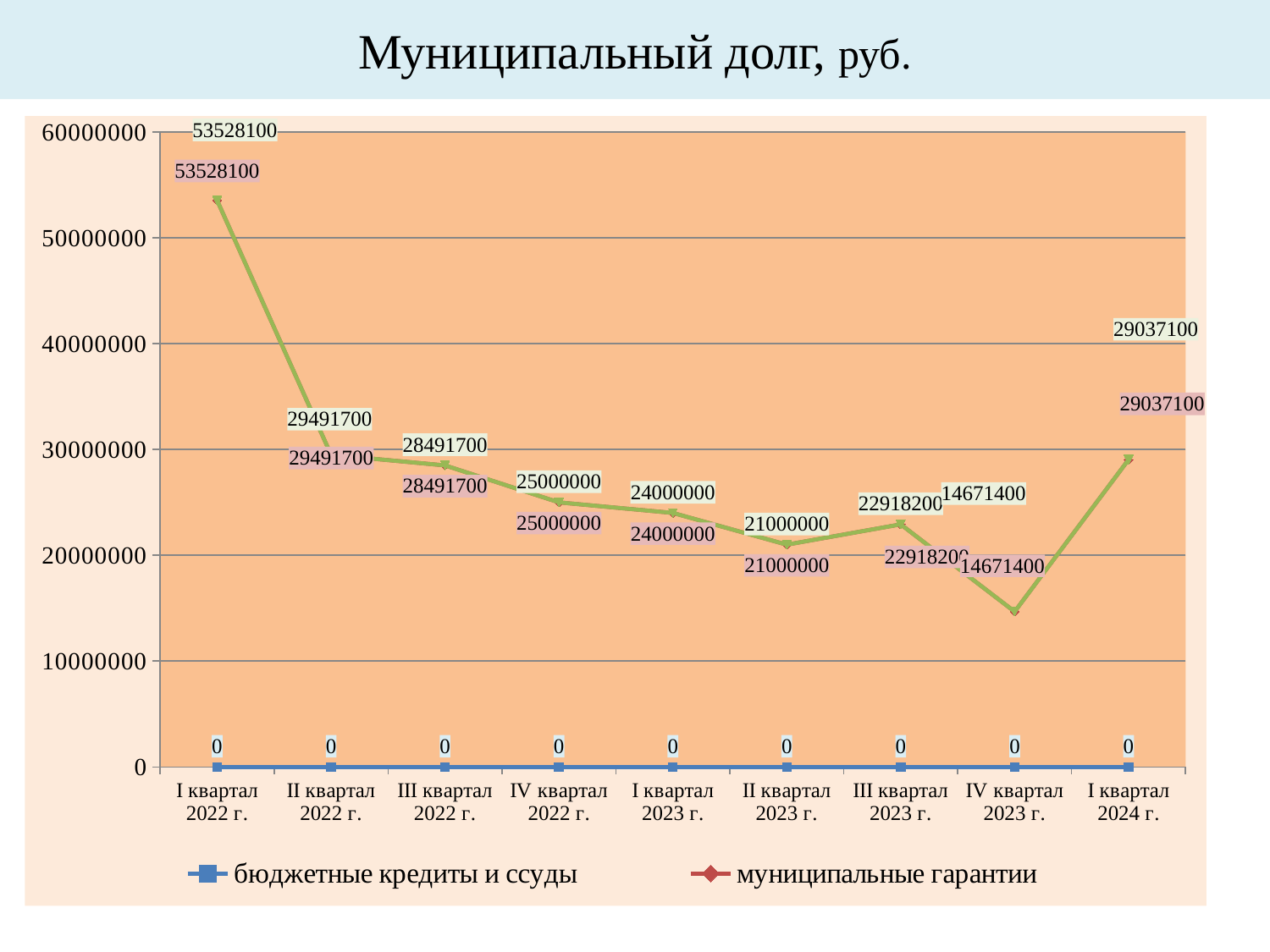
How many quarters are shown along the x axis? 9 What kind of chart is shown on the slide? line chart What value is labelled for бюджетные кредиты и ссуды in every quarter? 0 In which quarter does the upper line reach its lowest value? IV квартал 2023 г. What is the value labelled on the upper line for I квартал 2022 г.? 53528100 Which is larger on the upper line: the value for III квартал 2023 г. or the value for II квартал 2023 г.? III квартал 2023 г. In which quarter does the upper line reach its highest value? I квартал 2022 г. What is the value labelled on the upper line for I квартал 2024 г.? 29037100 What is the title of the chart? Муниципальный долг, руб. What is the difference between the upper line's values for I квартал 2022 г. and II квартал 2022 г.? 24036400 What is the value labelled on the upper line for IV квартал 2023 г.? 14671400 How many series does the legend list? 2